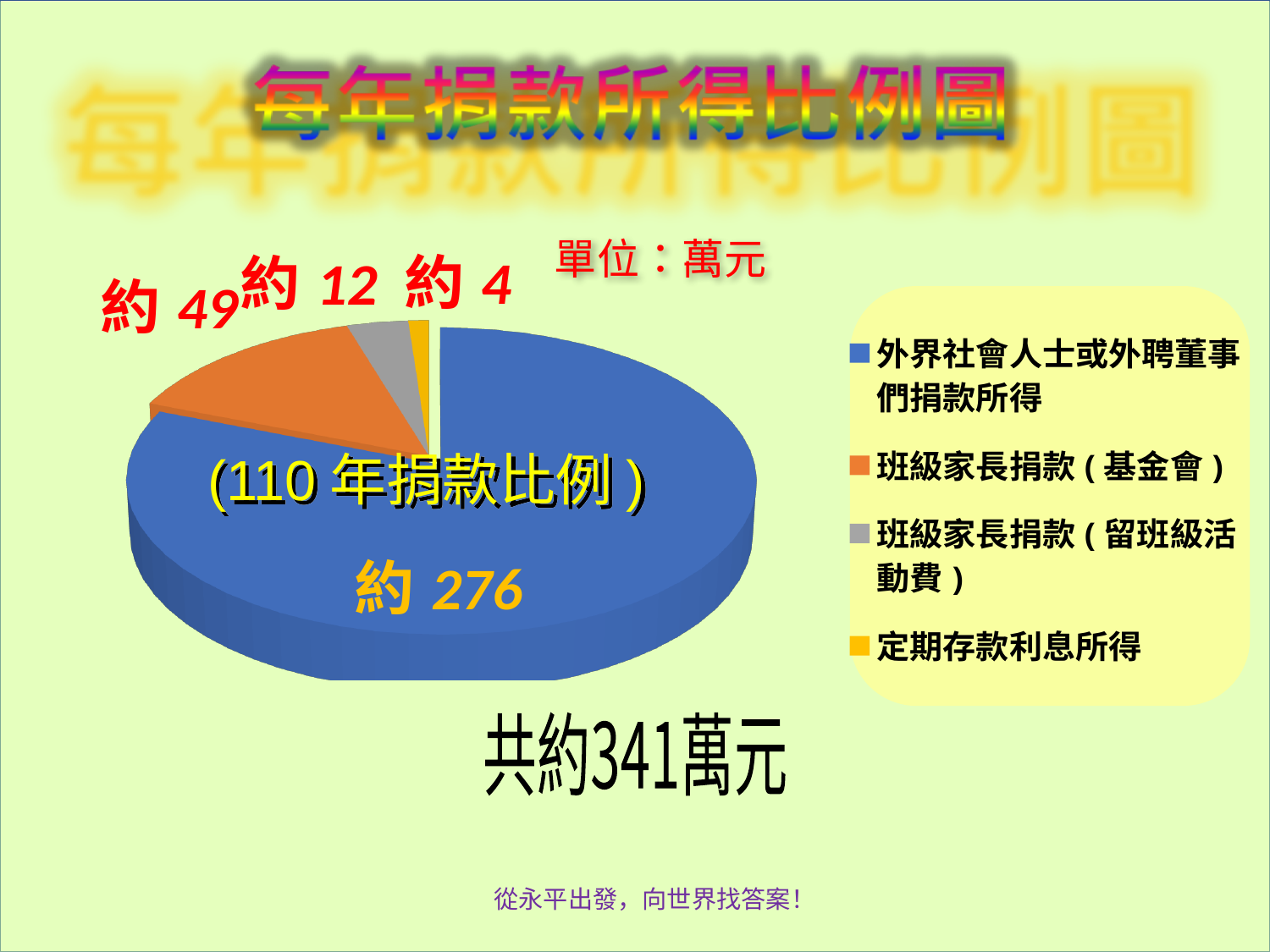
Which category has the largest slice of the pie? 外界社會人士或外聘董事們捐款所得 What value is labelled on the slice for 外界社會人士或外聘董事們捐款所得? 約 276 What value is labelled on the slice for 定期存款利息所得? 約 4 What total amount is stated below the pie chart? 共約341萬元 How many slices does the pie chart have? 4 What value is labelled on the slice for 班級家長捐款(基金會)? 約 49 What value is labelled on the slice for 班級家長捐款(留班級活動費)? 約 12 How many entries does the legend list? 4 Which category has the smallest slice of the pie? 定期存款利息所得 What unit is stated for the values in the chart? 萬元 Which is larger, the slice for 班級家長捐款(基金會) or the slice for 班級家長捐款(留班級活動費)? 班級家長捐款(基金會) What kind of chart is shown on the slide? pie chart